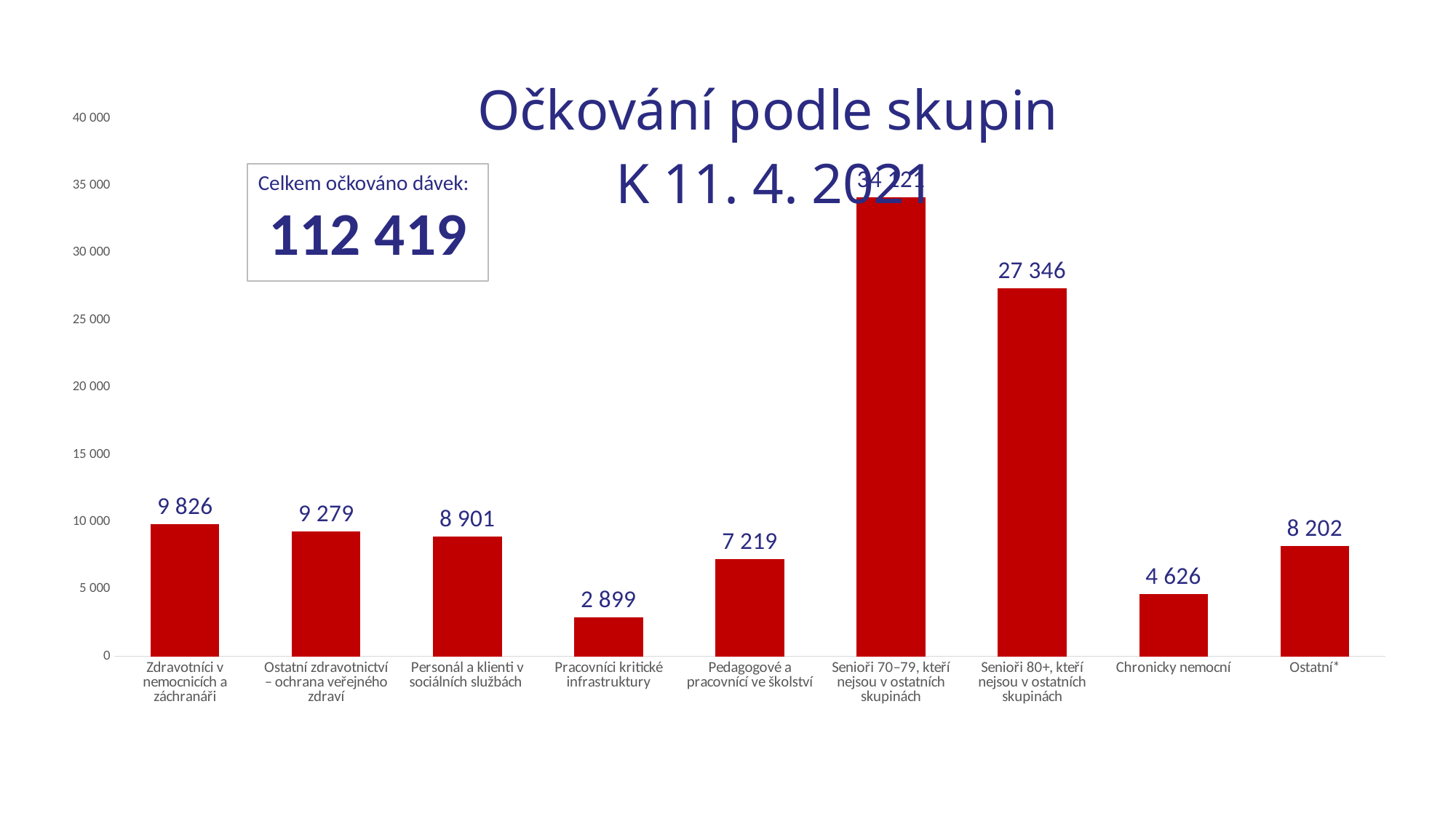
What is the difference between the values for Zdravotníci v nemocnicích a záchranáři and Ostatní zdravotnictví – ochrana veřejného zdraví? 547 What is the difference between the values for Pedagogové a pracovníci ve školství and Pracovníci kritické infrastruktury? 4 320 What kind of chart is shown on the slide? bar chart How many categories are shown on the x axis? 9 Which category has the lowest value? Pracovníci kritické infrastruktury Is the value for Senioři 70–79, kteří nejsou v ostatních skupinách greater or less than 30 000? greater What is the value for Ostatní*? 8 202 Which is larger: Personál a klienti v sociálních službách or Ostatní*? Personál a klienti v sociálních službách What is the value for Zdravotníci v nemocnicích a záchranáři? 9 826 What is the value for Senioři 80+, kteří nejsou v ostatních skupinách? 27 346 What is the value for Chronicky nemocní? 4 626 Which category has the highest value? Senioři 70–79, kteří nejsou v ostatních skupinách